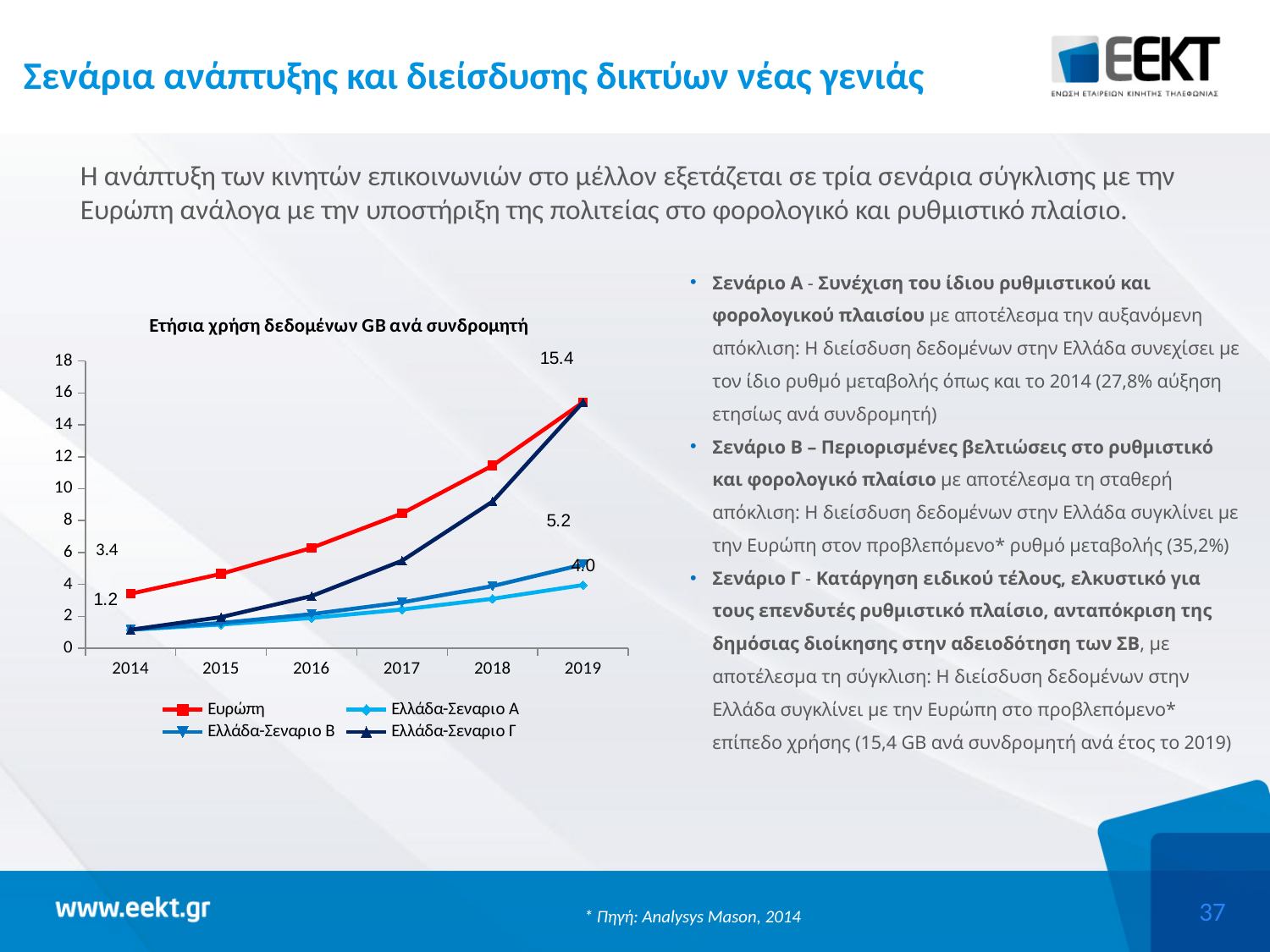
What is the title of the chart? Ετήσια χρήση δεδομένων GB ανά συνδρομητή Does the Ευρώπη series rise or fall from 2014 to 2019? Rises What is the value for Ευρώπη in 2019? 15.4 By how much does the Ευρώπη value increase from 2014 to 2019? 12.0 What is the value for Ελλάδα-Σεναριο Α in 2019? 4.0 Is the value for Ευρώπη in 2018 greater or less than 10? greater What is the value for Ευρώπη in 2014? 3.4 Which series has the lowest value in 2019? Ελλάδα-Σεναριο Α What is the value for Ελλάδα-Σεναριο Β in 2019? 5.2 What kind of chart is shown on the slide? Line chart How many years are shown on the x axis of the chart? 6 How many series does the chart legend list? 4